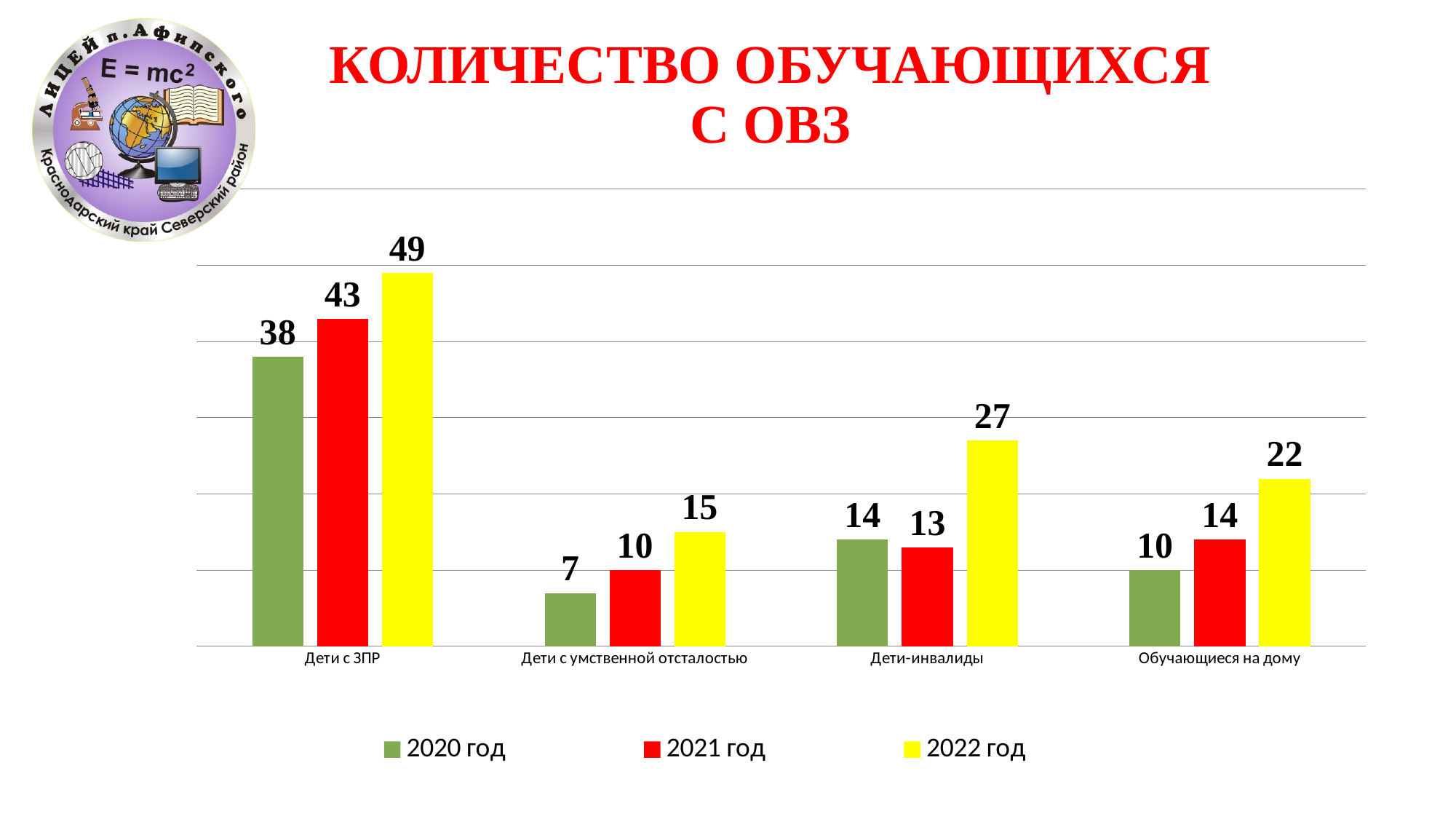
What is the value for 'Дети с ЗПР' in the '2022 год' series? 49 Which is larger for 'Дети-инвалиды': the '2020 год' value or the '2021 год' value? 2020 год What is the value for 'Дети-инвалиды' in the '2021 год' series? 13 What is the difference between the '2022 год' and '2020 год' values for 'Дети-инвалиды'? 13 Which category has the lowest value in the '2021 год' series? Дети с умственной отсталостью How many categories are shown on the x axis? 4 What kind of chart is shown on the slide? Bar chart Which colour represents the '2021 год' series? Red How many series does the legend list? 3 Do the values for 'Дети с умственной отсталостью' rise or fall from 2020 год to 2022 год? Rise Which category has the highest value in the '2020 год' series? Дети с ЗПР What is the value for 'Обучающиеся на дому' in the '2020 год' series? 10